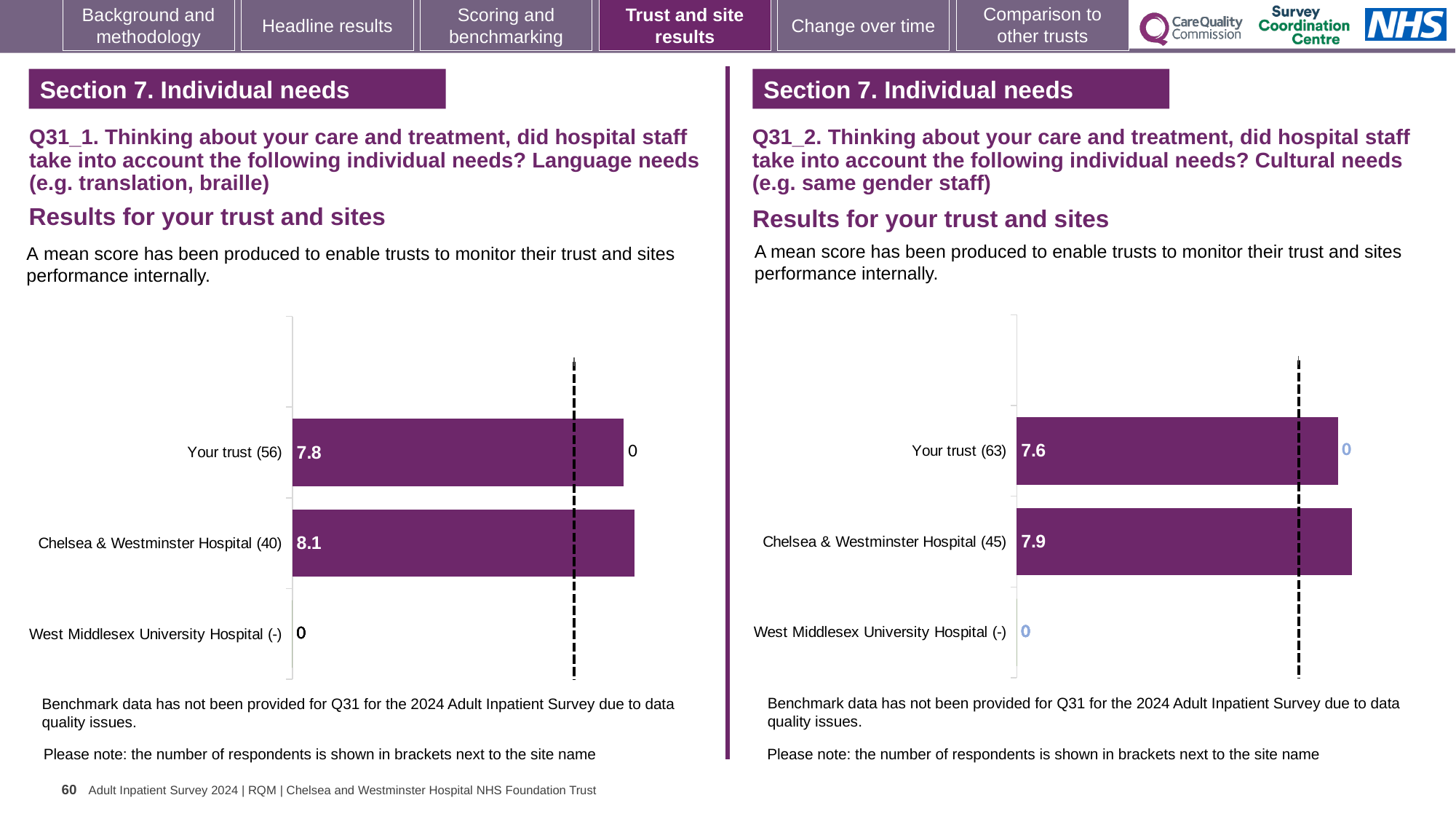
How many categories are shown in the left chart (Q31_1, Language needs)? 3 In the left chart (Q31_1, Language needs), which category has the highest mean score? Chelsea & Westminster Hospital (40) What kind of chart is used in the right chart (Q31_2, Cultural needs)? Bar chart In the right chart (Q31_2, Cultural needs), which is larger: the score for Your trust (63) or for Chelsea & Westminster Hospital (45)? Chelsea & Westminster Hospital (45) In the left chart (Q31_1, Language needs), what is the mean score for Your trust (56)? 7.8 In the right chart (Q31_2, Cultural needs), what is the difference between the scores for Chelsea & Westminster Hospital (45) and Your trust (63)? 0.3 In the left chart (Q31_1, Language needs), what is the mean score for Chelsea & Westminster Hospital (40)? 8.1 In the left chart (Q31_1, Language needs), how many respondents are shown in brackets for Your trust? 56 In the left chart (Q31_1, Language needs), what is the difference between the scores for Chelsea & Westminster Hospital (40) and Your trust (56)? 0.3 In the right chart (Q31_2, Cultural needs), what is the mean score for Your trust (63)? 7.6 In the right chart (Q31_2, Cultural needs), what is the mean score for Chelsea & Westminster Hospital (45)? 7.9 In the right chart (Q31_2, Cultural needs), which category has the highest mean score? Chelsea & Westminster Hospital (45)